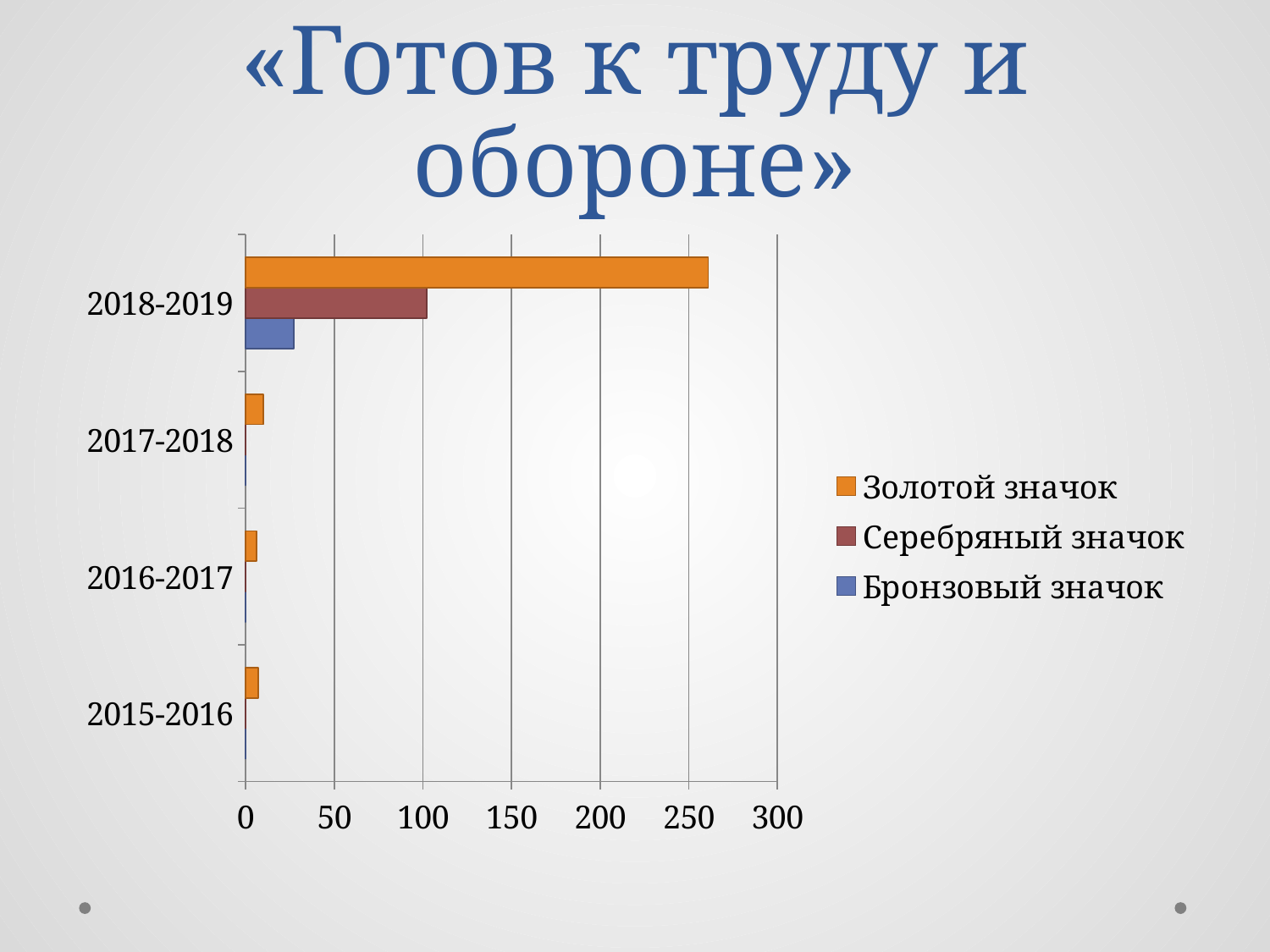
Is the value for Бронзовый значок in 2018-2019 greater or less than 50? less Is the value for Серебряный значок in 2018-2019 greater or less than 50? greater What is the title of the slide? «Готов к труду и обороне» Is the value for Золотой значок in 2018-2019 greater or less than 250? greater What kind of chart is shown on the slide? bar chart In 2018-2019, which is larger: Золотой значок or Серебряный значок? Золотой значок How many series does the legend list? 3 Which colour represents Бронзовый значок in the legend? blue Which school year has the highest value for Золотой значок? 2018-2019 Which school year has the highest value for Серебряный значок? 2018-2019 How many categories (school years) are shown on the chart? 4